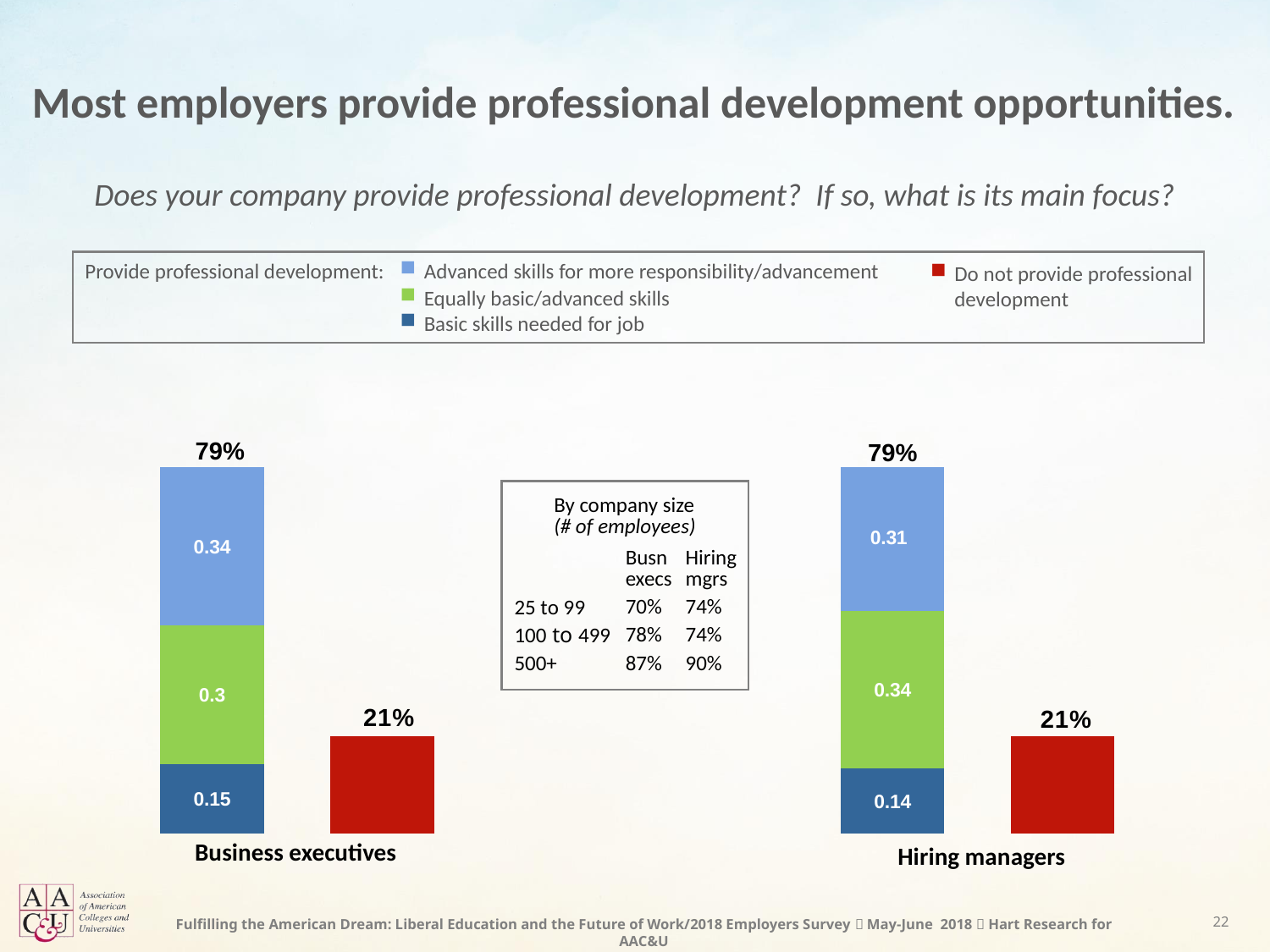
What kind of chart is used for the Business executives data? stacked bar chart In the Hiring managers chart, is the Advanced skills segment larger or smaller than the Equally basic/advanced skills segment? smaller In the Business executives chart, what is the value for the Advanced skills for more responsibility/advancement segment? 0.34 How many entries does the legend list? 4 In the Hiring managers chart, what is the value for the Basic skills needed for job segment? 0.14 In the Hiring managers chart, which segment of the stacked bar is the largest? Equally basic/advanced skills In the Business executives chart, what is the difference between the Advanced skills segment and the Basic skills segment? 0.19 In the Hiring managers chart, what percentage do not provide professional development? 21% In the Hiring managers chart, what is the value for the Equally basic/advanced skills segment? 0.34 In the Business executives chart, which segment of the stacked bar is the smallest? Basic skills needed for job In the Business executives chart, what is the value for the Basic skills needed for job segment? 0.15 In the Business executives chart, what is the total of the stacked bar for employers that provide professional development? 79%